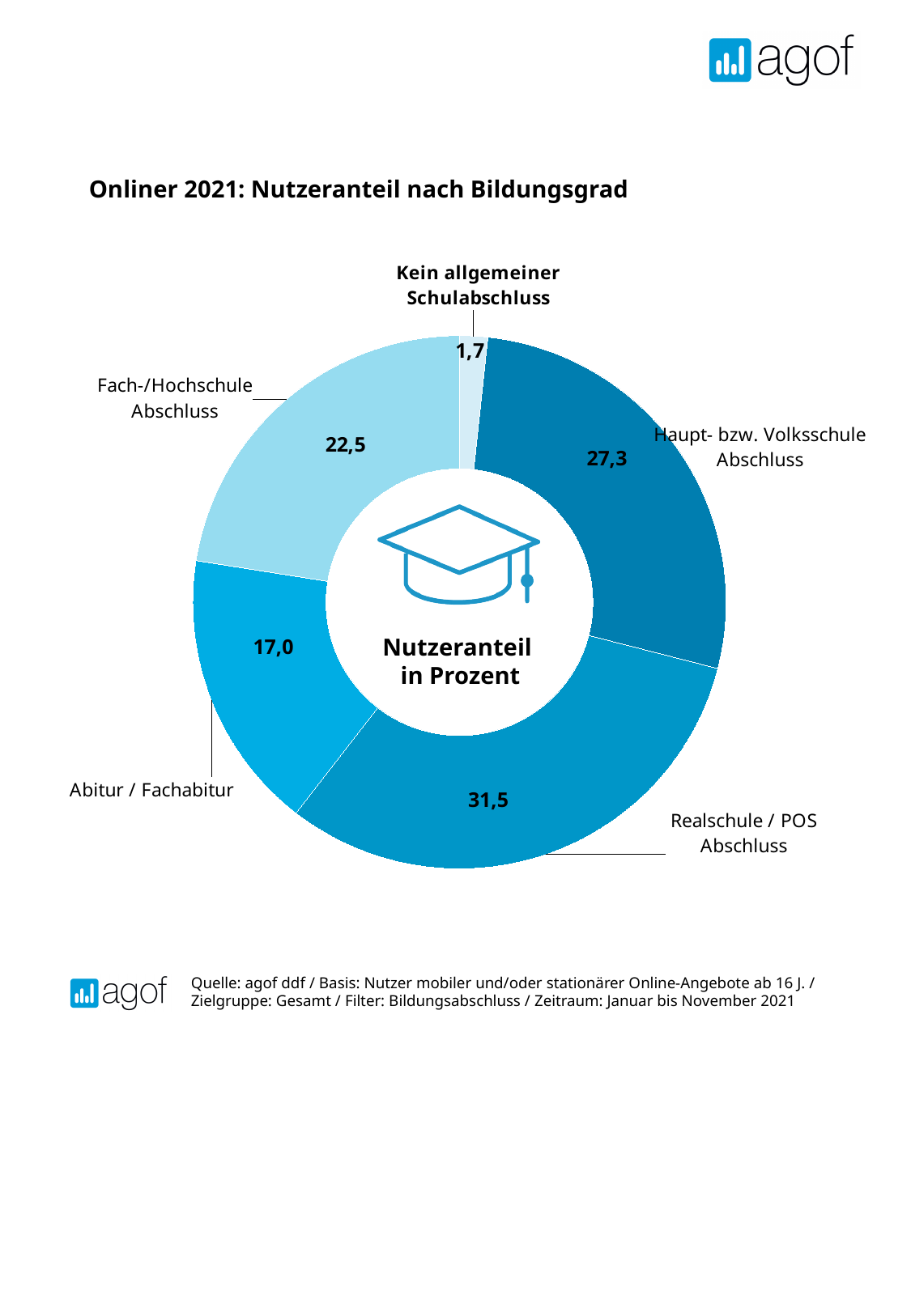
What is the value for Kein allgemeiner Schulabschluss? 1,7 How many categories does the chart show? 5 Which is larger, the value for Fach-/Hochschule Abschluss or the value for Abitur / Fachabitur? Fach-/Hochschule Abschluss What is the value for Haupt- bzw. Volksschule Abschluss? 27,3 What is the value for Fach-/Hochschule Abschluss? 22,5 What is the value for Abitur / Fachabitur? 17,0 What is the title of the chart? Onliner 2021: Nutzeranteil nach Bildungsgrad What kind of chart is shown on the slide? Pie chart (donut) What is the value for Realschule / POS Abschluss? 31,5 Which category has the highest share? Realschule / POS Abschluss What is the difference between the values for Realschule / POS Abschluss and Haupt- bzw. Volksschule Abschluss? 4,2 Which category has the lowest share? Kein allgemeiner Schulabschluss